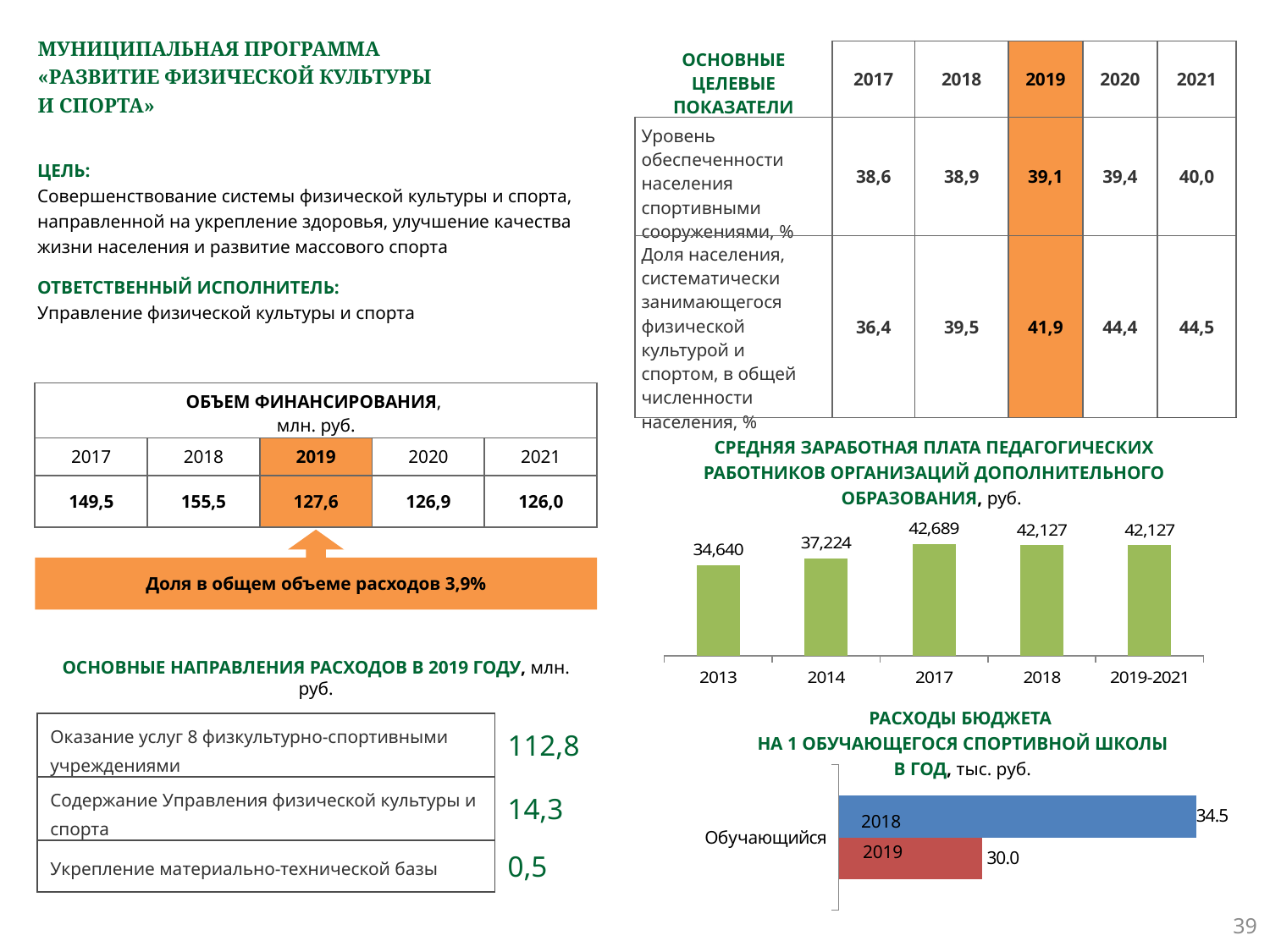
In the chart 'Средняя заработная плата педагогических работников организаций дополнительного образования', which category has the highest value? 2017 In the chart 'Расходы бюджета на 1 обучающегося спортивной школы в год', what is the value for 2018? 34.5 In the chart 'Средняя заработная плата педагогических работников организаций дополнительного образования', what is the value for 2019-2021? 42,127 In the chart 'Средняя заработная плата педагогических работников организаций дополнительного образования', which category has the lowest value? 2013 What kind of chart is 'Средняя заработная плата педагогических работников организаций дополнительного образования'? Bar chart In the chart 'Средняя заработная плата педагогических работников организаций дополнительного образования', what is the difference between the values for 2014 and 2013? 2,584 In the chart 'Средняя заработная плата педагогических работников организаций дополнительного образования', what is the value for 2013? 34,640 In the chart 'Расходы бюджета на 1 обучающегося спортивной школы в год', what is the value for 2019? 30.0 In the chart 'Средняя заработная плата педагогических работников организаций дополнительного образования', what is the value for 2017? 42,689 In the chart 'Расходы бюджета на 1 обучающегося спортивной школы в год', what is the difference between the values for 2018 and 2019? 4.5 In the chart 'Средняя заработная плата педагогических работников организаций дополнительного образования', how many categories are shown on the x axis? 5 In the chart 'Расходы бюджета на 1 обучающегося спортивной школы в год', which is larger, the value for 2018 or 2019? 2018